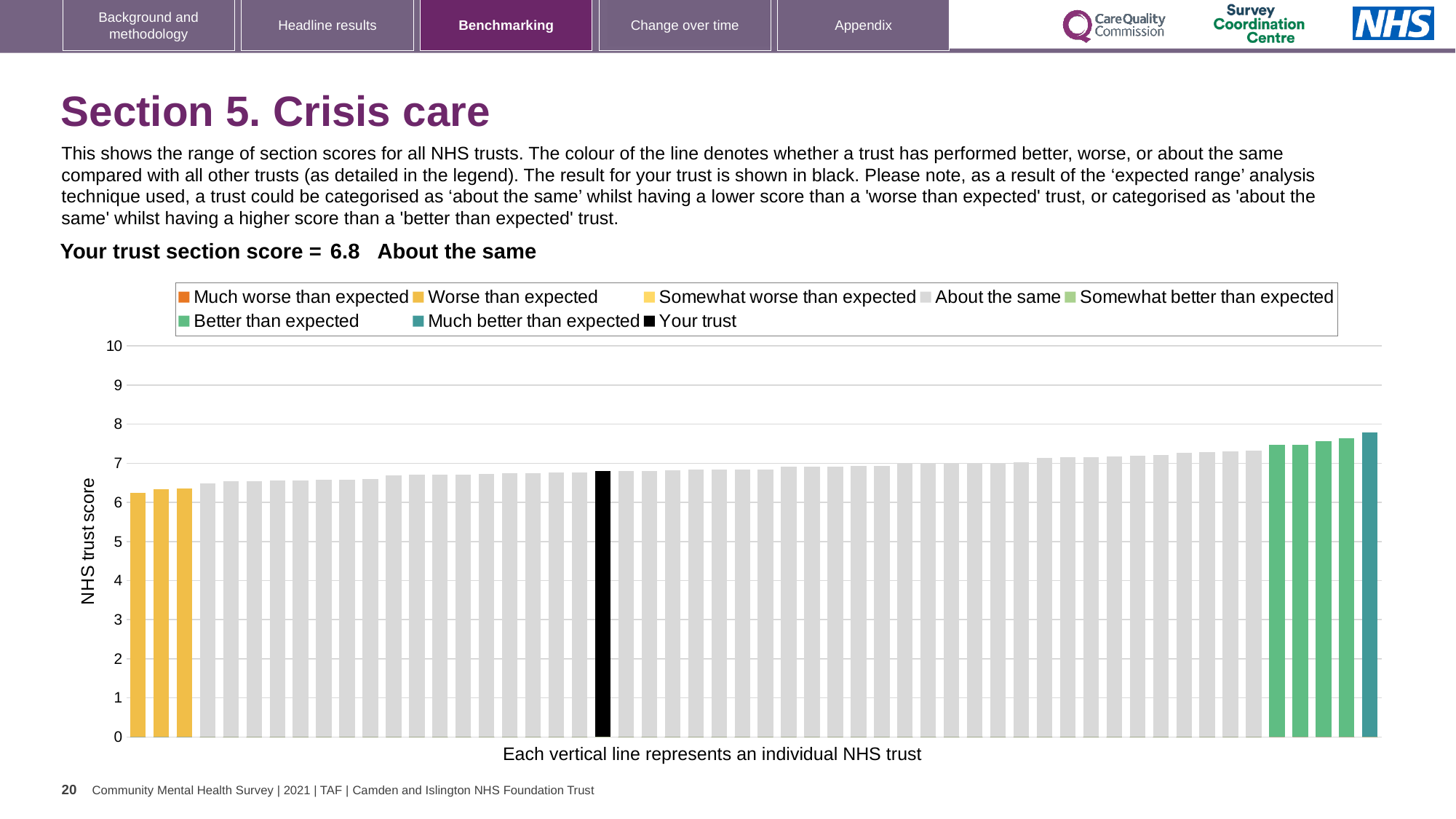
What is the label on the vertical axis of the chart? NHS trust score How many entries does the chart legend list? 8 Do the bar values rise or fall from left to right along the x axis? rise Which category is the trust's section score placed in, according to the text above the chart? About the same What kind of chart is shown on the slide? bar chart How many bars are coloured as 'Better than expected' (green)? 4 How many bars are coloured as 'Worse than expected' (yellow)? 3 Is the value of the rightmost (teal, 'Much better than expected') bar greater or less than 7? greater What is the trust section score shown on the slide? 6.8 Is the black 'Your trust' bar higher or lower than the rightmost teal bar? lower Is the value of the black 'Your trust' bar greater or less than 6? greater Is the value of the black 'Your trust' bar greater or less than 7? less